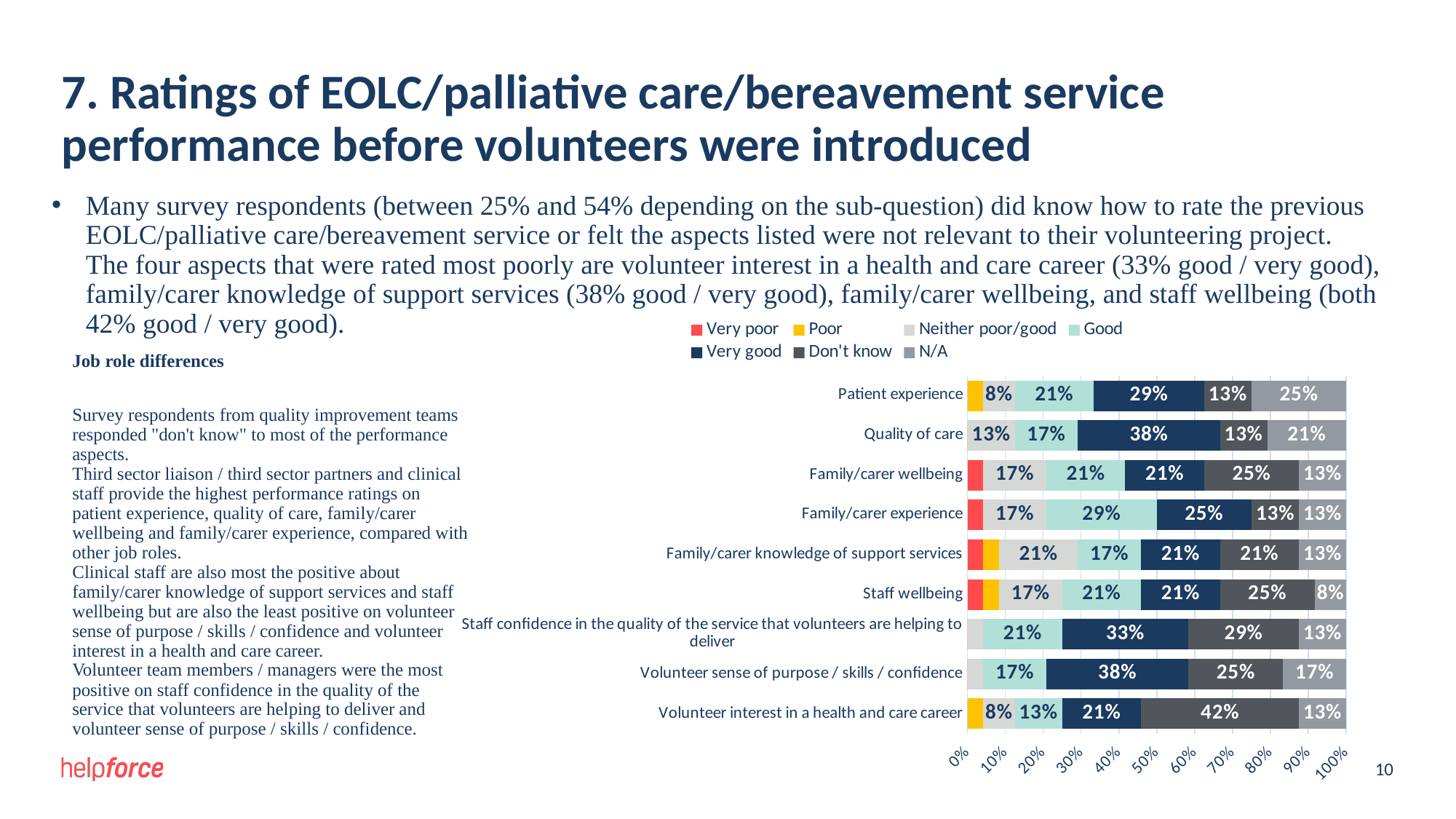
What is the 'Very good' value for Quality of care? 38% What kind of chart is shown on the slide? Stacked bar chart What is the 'Don't know' value for Volunteer interest in a health and care career? 42% Which aspect has the lowest 'N/A' value? Staff wellbeing How many series does the chart legend list? 7 Which has a larger 'Good' value: Family/carer experience or Quality of care? Family/carer experience What is the 'Good' value for Family/carer experience? 29% Which aspect has the highest 'Don't know' value? Volunteer interest in a health and care career What is the difference between the 'Very good' values for Patient experience and Family/carer wellbeing? 8 percentage points Which legend entry is shown in red? Very poor How many performance aspects (categories) are plotted in the chart? 9 What is the 'N/A' value for Patient experience? 25%